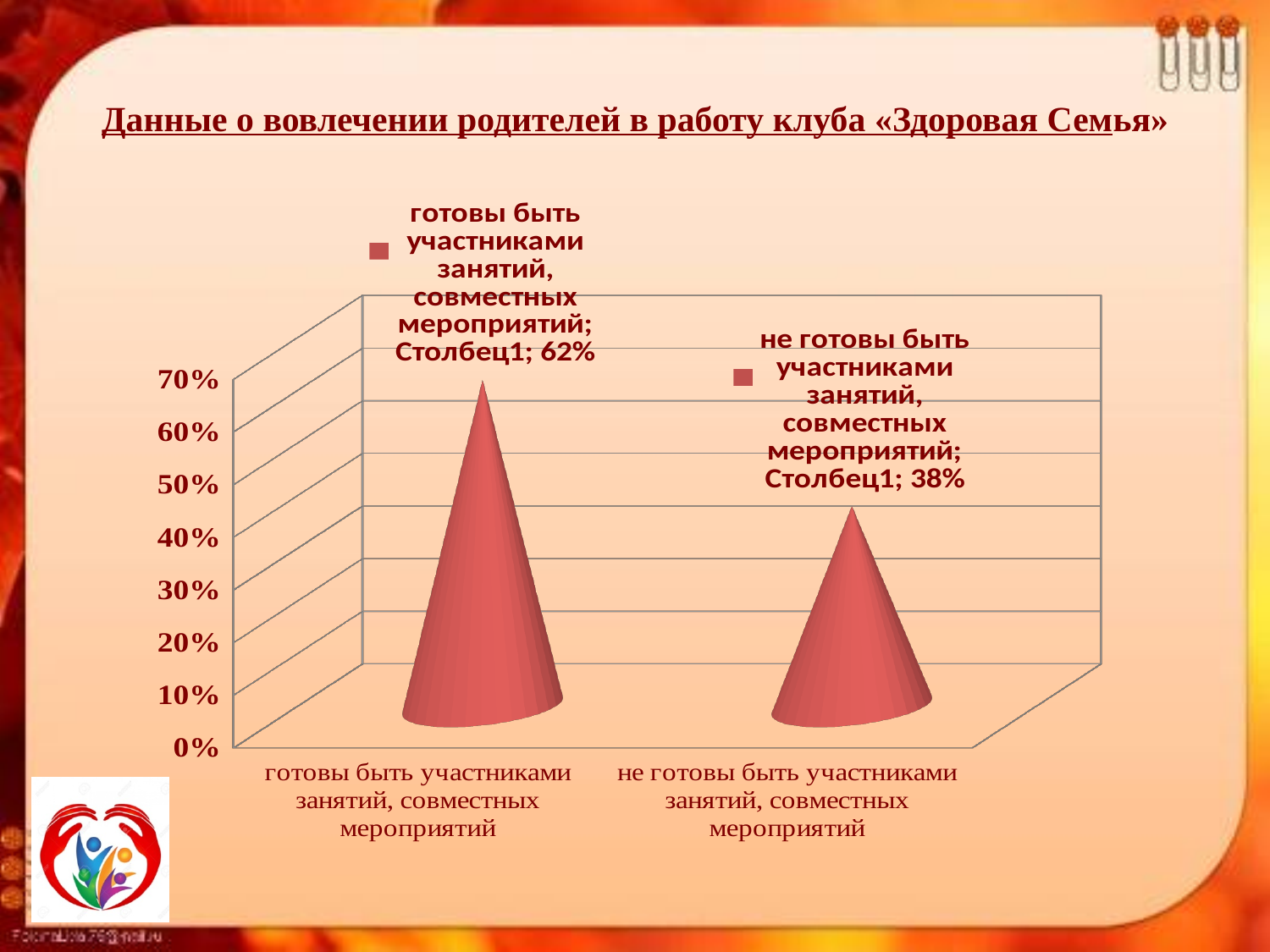
What is the value for "готовы быть участниками занятий, совместных мероприятий"? 62% How many categories are shown on the chart? 2 Which category has the highest value? готовы быть участниками занятий, совместных мероприятий What is the difference between the value for "готовы быть участниками" and the value for "не готовы быть участниками"? 24% Is the value for "не готовы быть участниками занятий, совместных мероприятий" greater or less than 40%? less Is the value for "готовы быть участниками занятий, совместных мероприятий" greater or less than 50%? greater What kind of chart is shown on the slide? bar chart What is the value for "не готовы быть участниками занятий, совместных мероприятий"? 38% Which is larger: the value for "готовы быть участниками" or the value for "не готовы быть участниками"? готовы быть участниками занятий, совместных мероприятий Which category has the lowest value? не готовы быть участниками занятий, совместных мероприятий What is the title of the slide containing the chart? Данные о вовлечении родителей в работу клуба «Здоровая Семья» What is the total of the two values shown on the chart? 100%